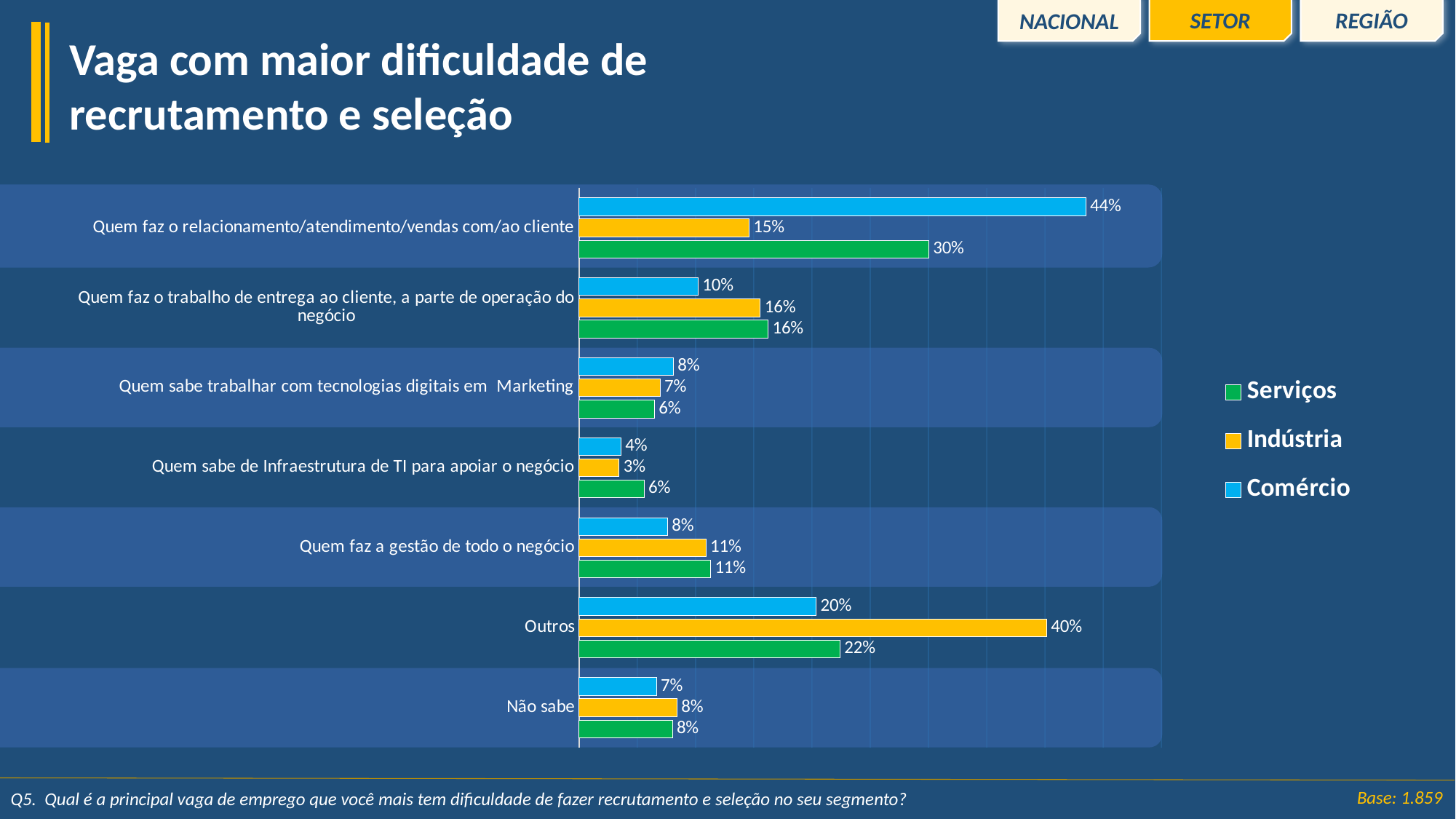
What is the difference between the Comércio and Indústria values for 'Quem faz o relacionamento/atendimento/vendas com/ao cliente'? 29% How many series does the legend list? 3 How many categories are shown on the chart? 7 What is the Serviços value for 'Quem sabe de Infraestrutura de TI para apoiar o negócio'? 6% What is the Comércio value for 'Quem faz o relacionamento/atendimento/vendas com/ao cliente'? 44% Which series is shown in green in the legend? Serviços Which category has the lowest Indústria value? Quem sabe de Infraestrutura de TI para apoiar o negócio What is the Indústria value for 'Outros'? 40% Which category has the highest Serviços value? Quem faz o relacionamento/atendimento/vendas com/ao cliente What is the difference between the Serviços and Comércio values for 'Quem faz o trabalho de entrega ao cliente, a parte de operação do negócio'? 6% For 'Outros', which series has the larger value, Indústria or Serviços? Indústria What type of chart is shown on the slide? Bar chart